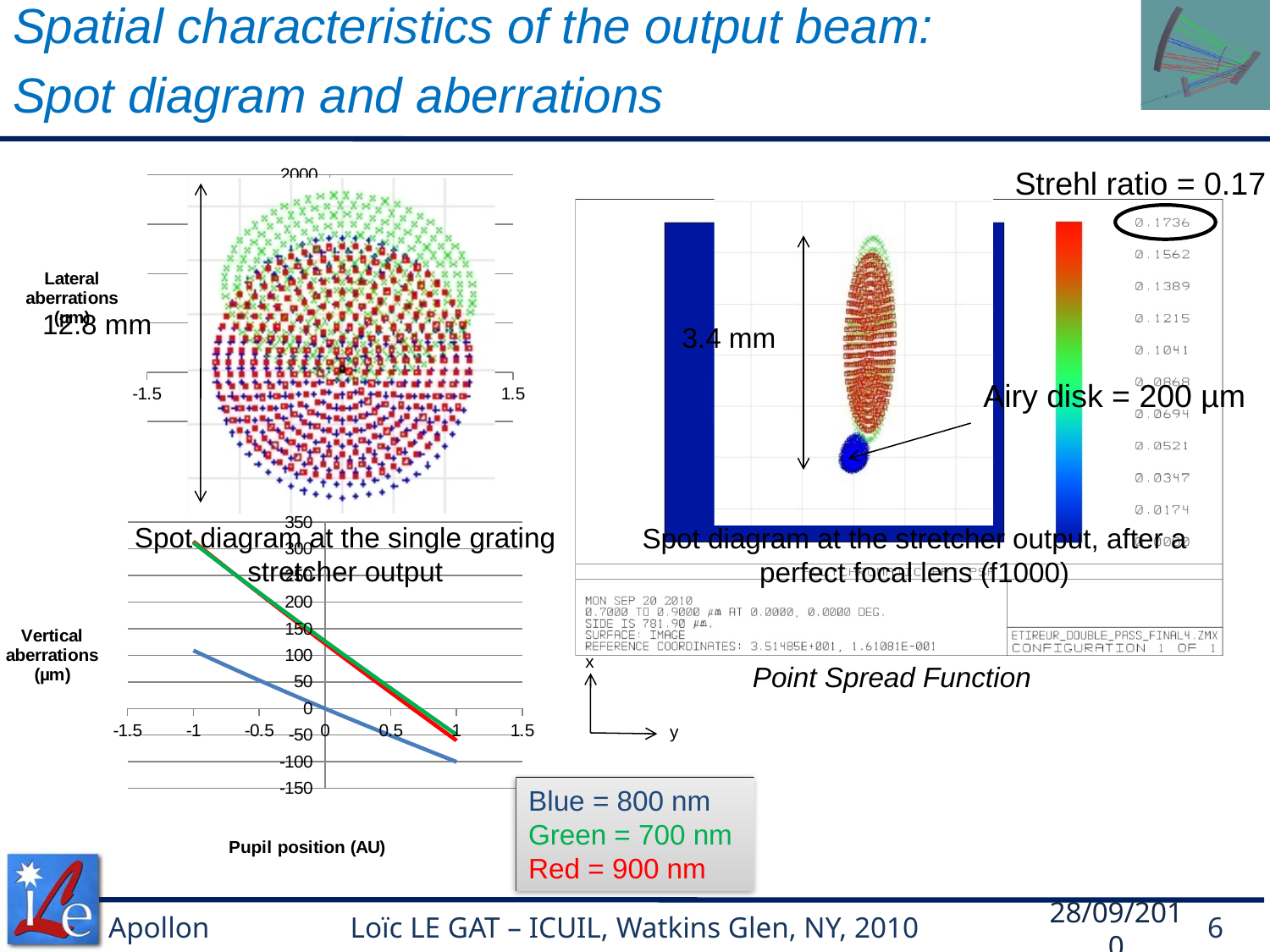
What kind of chart is the bottom-left chart of vertical aberrations versus pupil position? line chart In the vertical aberrations chart, do the values rise or fall as pupil position increases? fall What wavelength does the blue line represent in the vertical aberrations chart? 800 nm In the vertical aberrations chart, is the blue line's value at pupil position 1 greater or less than 0? less How many series does the legend list for the vertical aberrations chart? 3 In the vertical aberrations chart, at pupil position -1, which line is higher, the blue line or the green line? green In the vertical aberrations chart, is the red line's value at pupil position 1 greater or less than 0? less What Airy disk size is stated on the Point Spread Function chart on the right? 200 µm What is the x-axis label of the vertical aberrations chart? Pupil position (AU) In the vertical aberrations chart, is the blue line's value at pupil position -1 greater or less than 50? greater What Strehl ratio is stated for the Point Spread Function chart on the right? 0.17